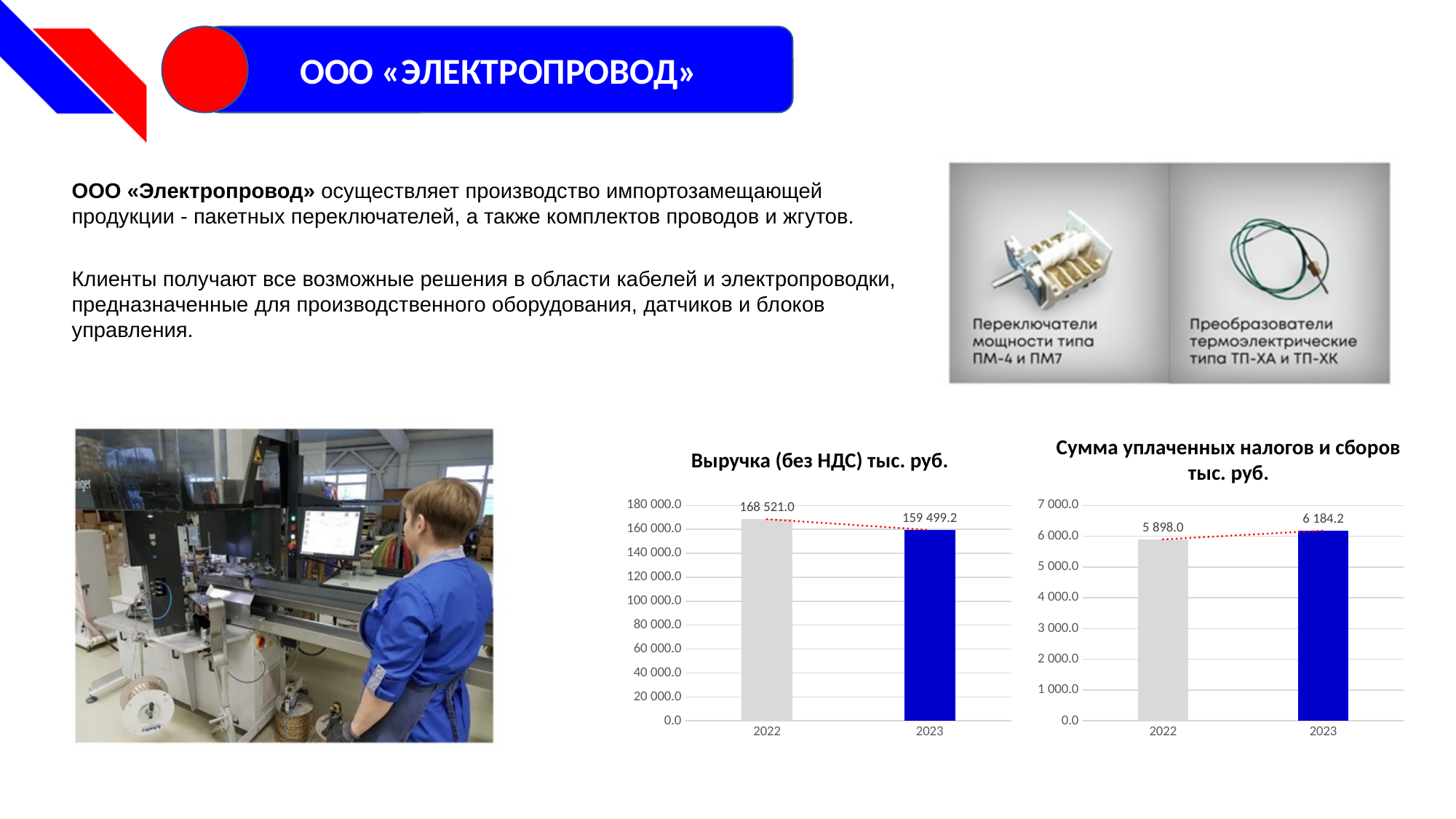
In the chart titled "Сумма уплаченных налогов и сборов тыс. руб.", what is the value for 2023? 6 184.2 In the chart titled "Сумма уплаченных налогов и сборов тыс. руб.", what is the value for 2022? 5 898.0 In the chart titled "Сумма уплаченных налогов и сборов тыс. руб.", which year has the lower value? 2022 What kind of chart is the one titled "Выручка (без НДС) тыс. руб."? bar chart How many years are shown on the x axis of the chart titled "Сумма уплаченных налогов и сборов тыс. руб."? 2 In the chart titled "Выручка (без НДС) тыс. руб.", by how much does the 2022 value exceed the 2023 value? 9 021.8 In the chart titled "Выручка (без НДС) тыс. руб.", do the values rise or fall from 2022 to 2023? fall In the chart titled "Выручка (без НДС) тыс. руб.", what is the value for 2023? 159 499.2 In the chart titled "Сумма уплаченных налогов и сборов тыс. руб.", do the values rise or fall from 2022 to 2023? rise In the chart titled "Выручка (без НДС) тыс. руб.", which year has the higher value? 2022 In the chart titled "Выручка (без НДС) тыс. руб.", what is the value for 2022? 168 521.0 In the chart titled "Сумма уплаченных налогов и сборов тыс. руб.", what is the difference between the 2023 and 2022 values? 286.2